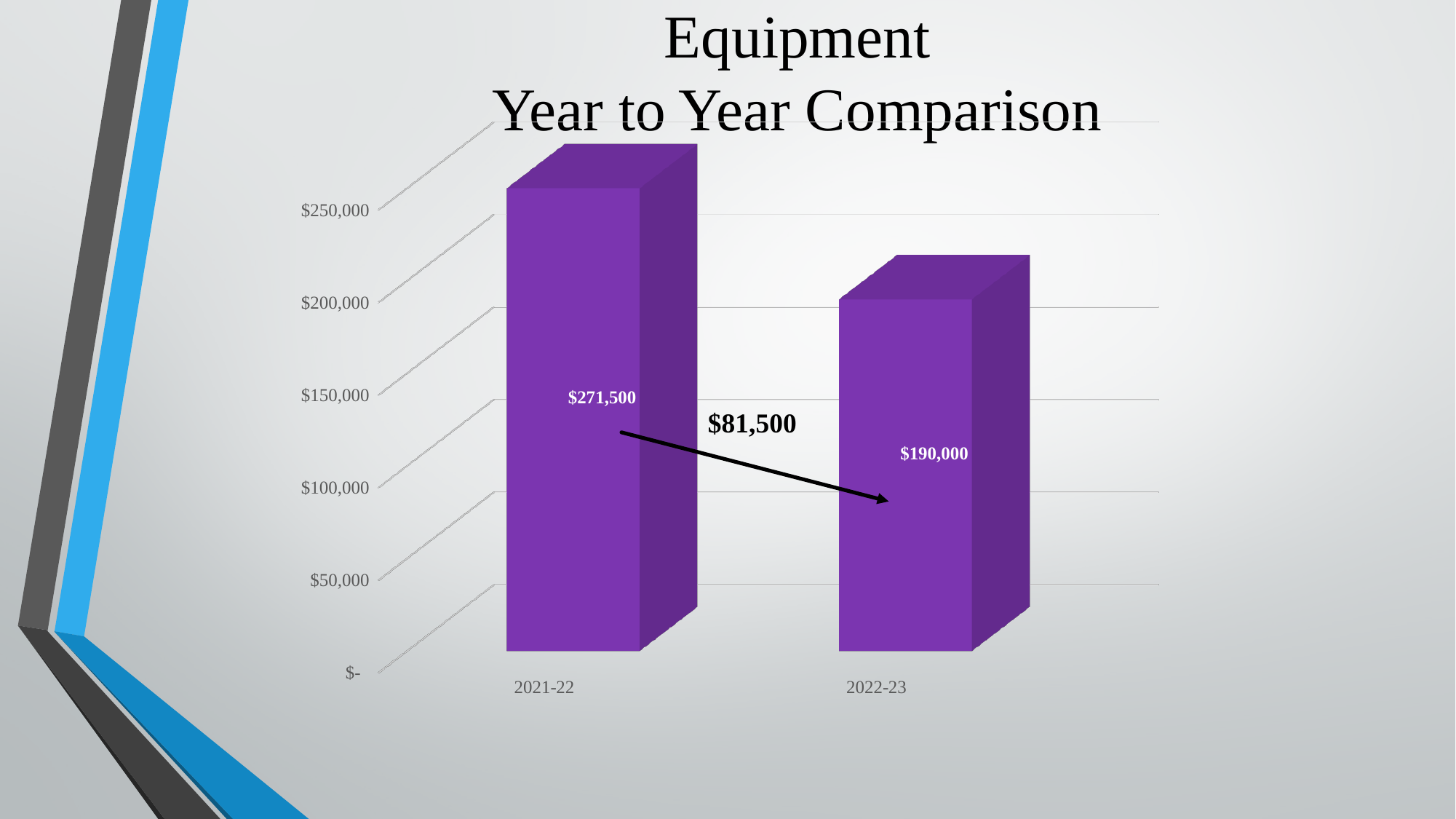
Is the value for 2022-23 greater or less than $200,000? less What is the value for 2021-22? $271,500 What is the difference between the 2021-22 and 2022-23 values? $81,500 Is the value for 2021-22 greater or less than $250,000? greater Which is larger, the value for 2021-22 or the value for 2022-23? 2021-22 Which year has the lowest value? 2022-23 What is the title of the chart? Equipment Year to Year Comparison Do the values rise or fall from 2021-22 to 2022-23? fall Which year has the highest value? 2021-22 What kind of chart is shown on the slide? bar chart What is the value for 2022-23? $190,000 How many categories are shown on the x axis? 2